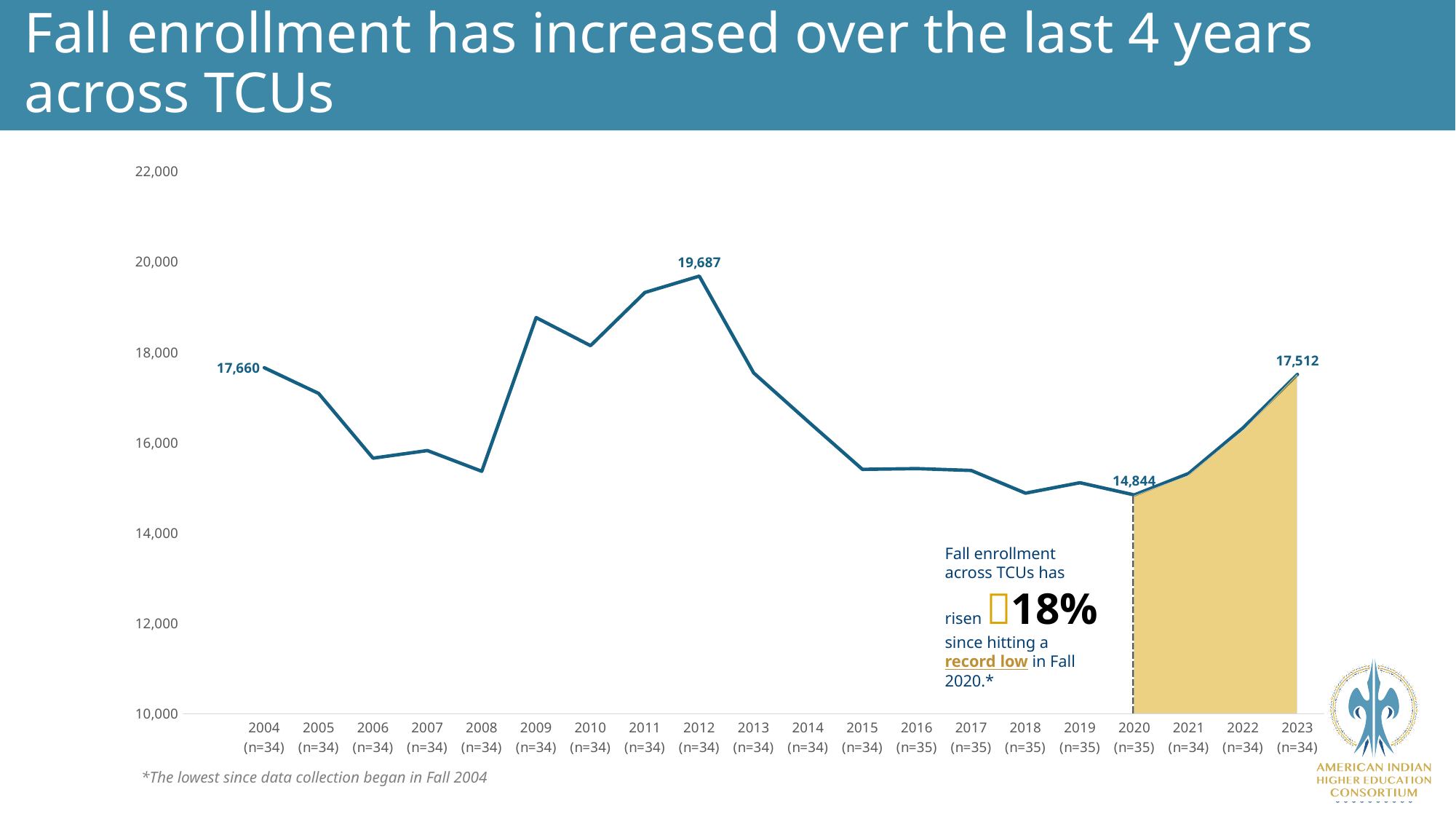
Which year had the lowest fall enrollment? 2020 What was fall enrollment across TCUs in 2023? 17,512 What type of chart is shown on the slide? line chart How many years are plotted on the x axis? 20 By how much did fall enrollment increase from 2020 to 2023? 2,668 Which year had the highest fall enrollment? 2012 Is the fall enrollment value for 2009 greater or less than 18,000? greater What was fall enrollment across TCUs in 2004? 17,660 Does fall enrollment rise or fall from 2020 to 2023? rise What was fall enrollment across TCUs in 2020? 14,844 Is the fall enrollment value for 2015 greater or less than 16,000? less Was fall enrollment higher in 2004 or in 2023? 2004